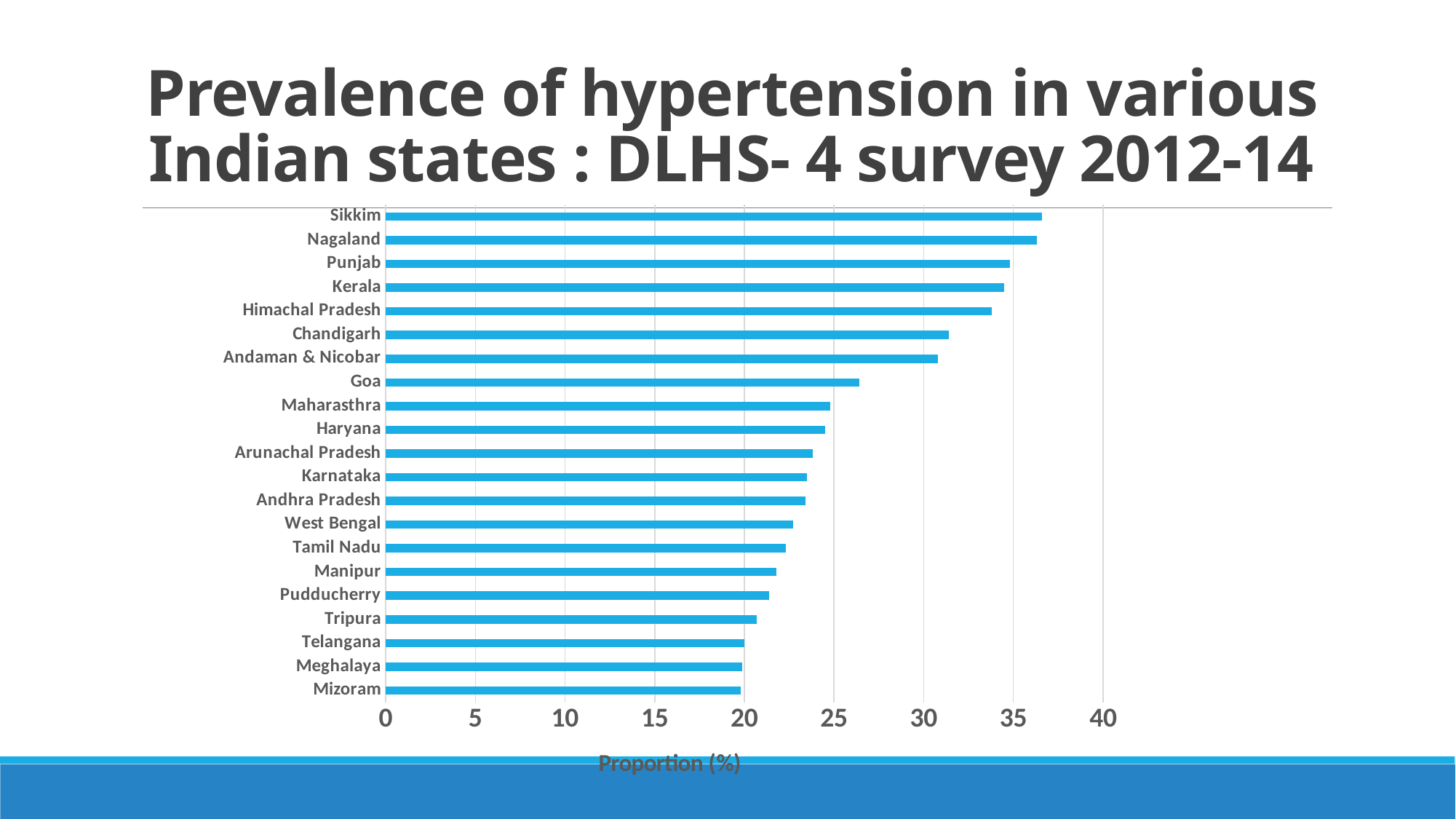
What kind of chart is shown on the slide? bar chart Is the value for Sikkim greater or less than 35? greater Which has the higher prevalence, Punjab or Goa? Punjab Is the value for Chandigarh greater or less than 30? greater Is the value for Manipur greater or less than 20? greater How many states or territories are plotted in the chart? 21 Which has the higher prevalence, Karnataka or Kerala? Kerala Are the bars arranged in increasing or decreasing order from top to bottom? decreasing What is the label on the horizontal axis of the chart? Proportion (%)